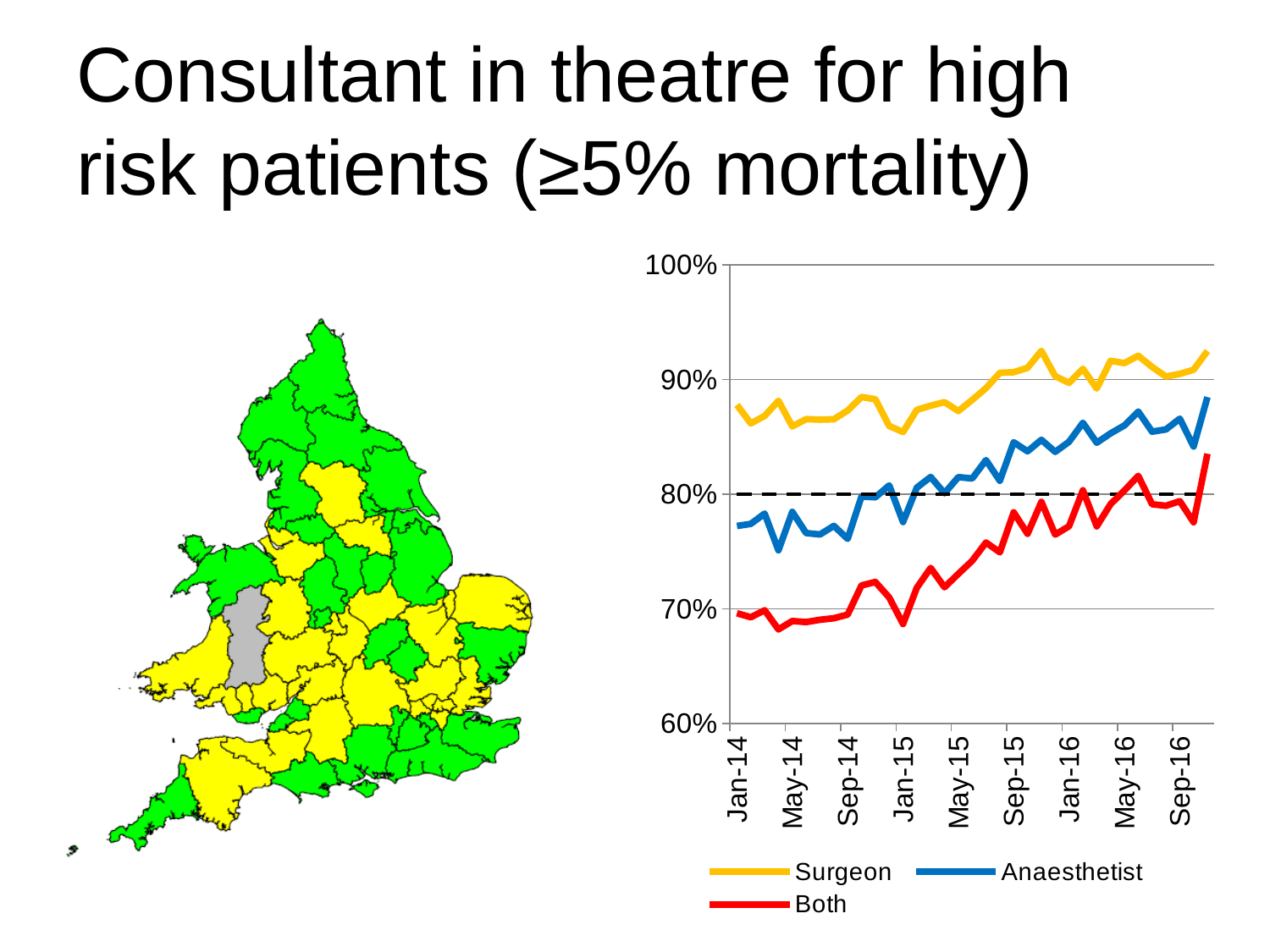
In the line chart, is the value for Surgeon in Jan-14 greater or less than 80%? greater In the line chart, does the Both series generally rise or fall from Jan-14 to Sep-16? rise In the line chart, is the value for Anaesthetist in Sep-16 greater or less than 80%? greater How many series does the legend of the line chart list? 3 In the line chart, which is larger in May-15: the Anaesthetist value or the Both value? Anaesthetist Which series in the line chart has the lowest values throughout the period? Both Which series in the line chart has the highest values throughout the period? Surgeon In the line chart, is the value for Anaesthetist in Jan-14 greater or less than 80%? less What kind of chart is shown on the right of the slide? line chart What colour is the Anaesthetist line in the chart? blue